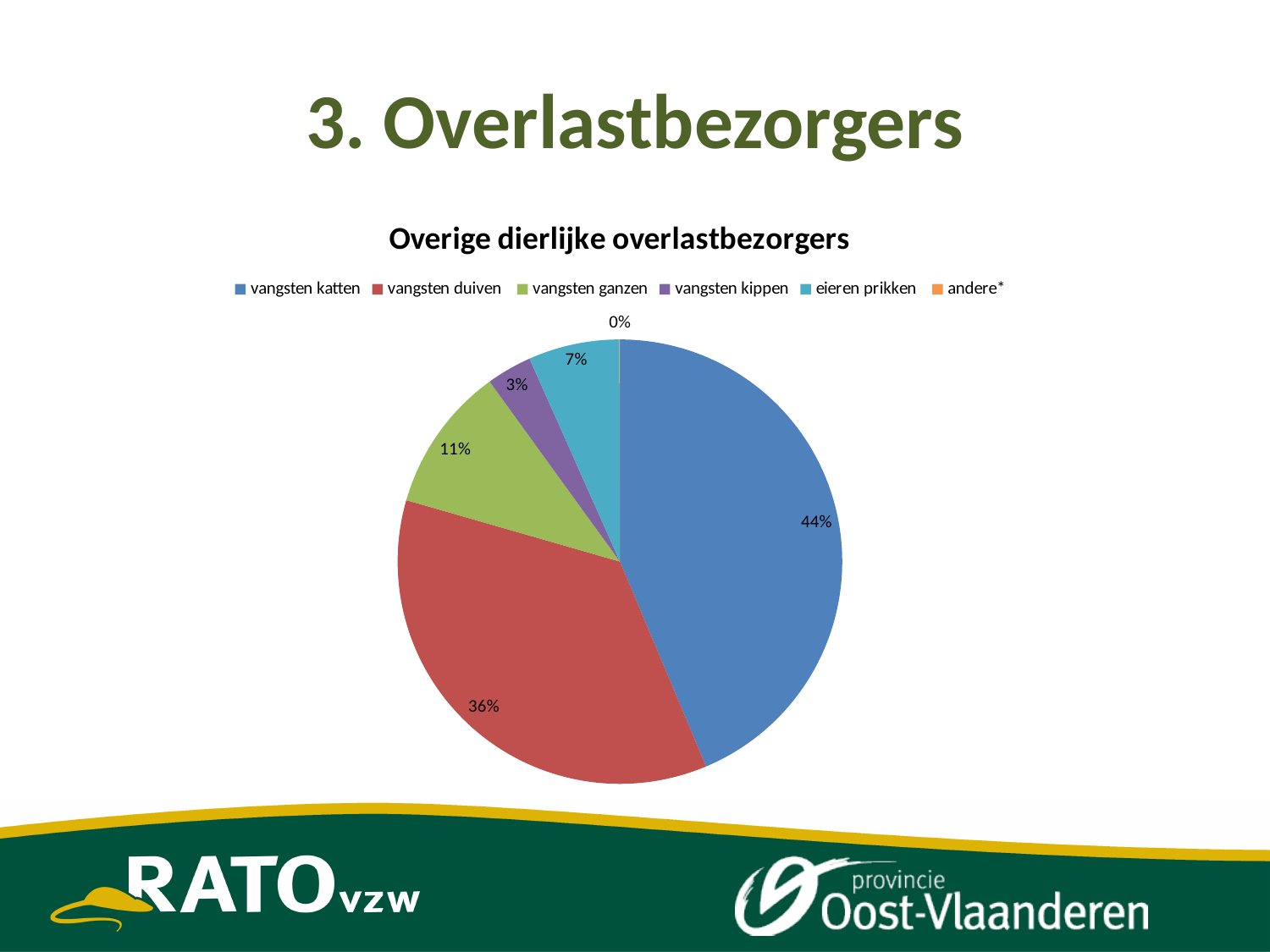
Which category has the smallest slice of the pie? andere* What share of the pie does 'andere*' represent? 0% What share of the pie does 'vangsten kippen' represent? 3% What share of the pie does 'eieren prikken' represent? 7% What is the difference in percentage points between 'vangsten katten' and 'vangsten duiven'? 8% What kind of chart is shown on the slide? pie chart What is the title of the chart? Overige dierlijke overlastbezorgers Which category has the largest slice of the pie? vangsten katten How many categories does the legend of the pie chart list? 6